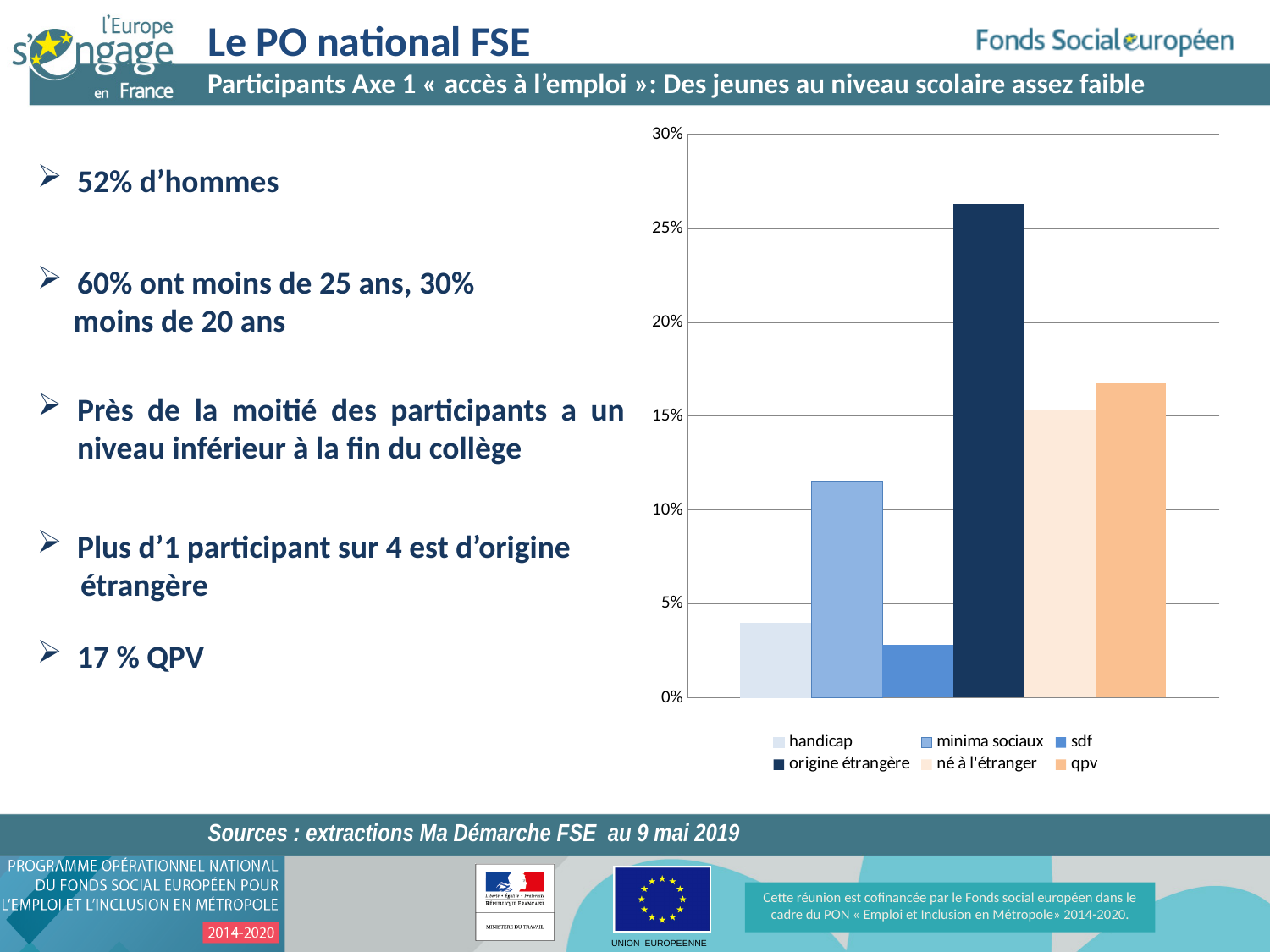
Which series has the highest bar in the chart? origine étrangère How many series does the chart legend list? 6 Which series has the lowest bar in the chart? sdf How many bars are plotted in the chart? 6 Is the value for handicap greater or less than 5%? less Which is larger, the value for qpv or the value for minima sociaux? qpv What is the highest value shown on the chart's vertical axis? 30% Is the value for origine étrangère greater or less than 25%? greater Is the value for minima sociaux greater or less than 10%? greater What kind of chart is shown on the slide? bar chart Which is larger, the value for origine étrangère or the value for né à l'étranger? origine étrangère